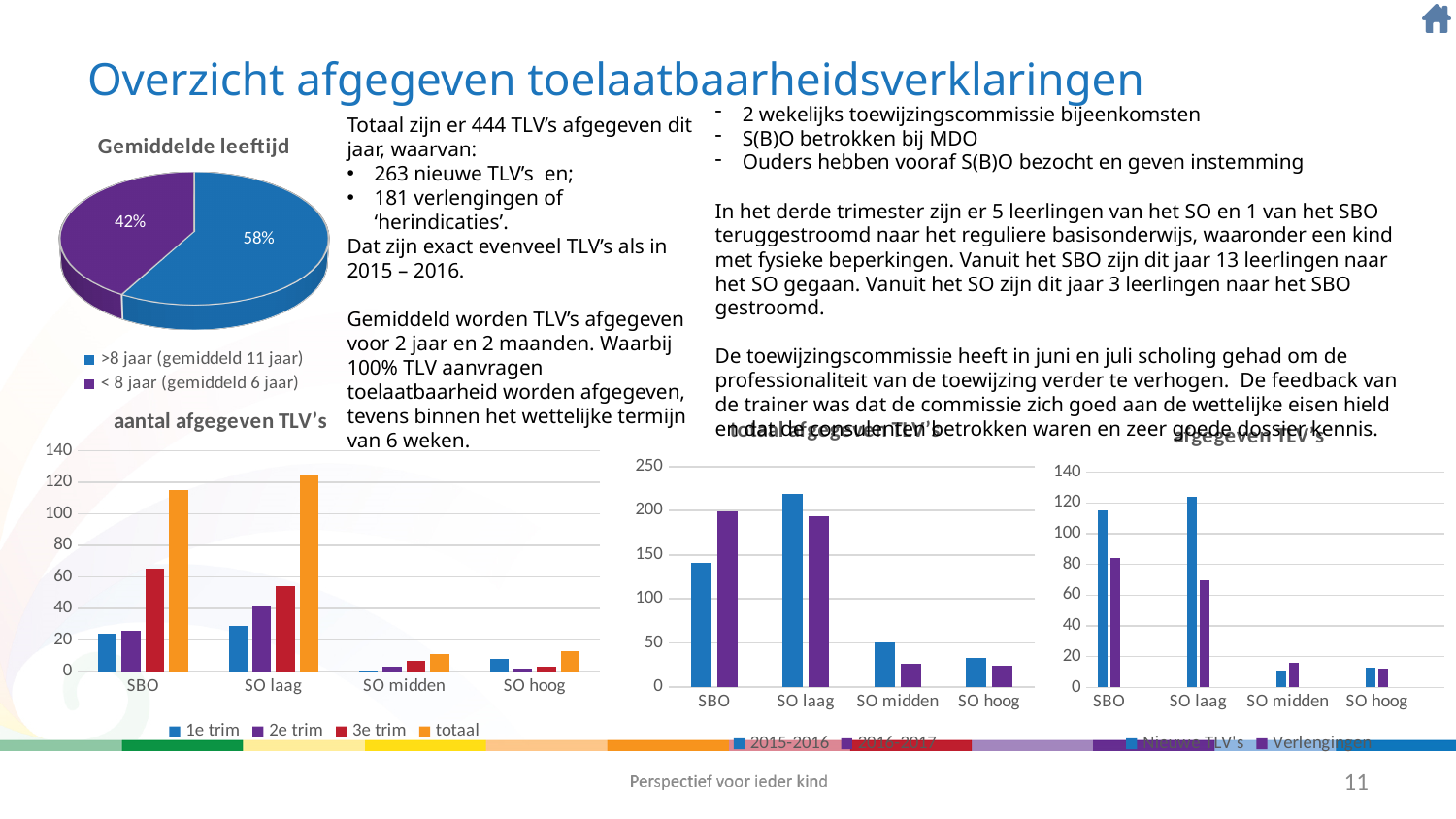
In the middle bar chart at the bottom of the slide, which series has the larger value for SBO: '2015-2016' or '2016-2017'? 2016-2017 In the bar chart 'afgegeven TLV's' at the bottom right, is the 'Nieuwe TLV's' value for SBO greater or less than 100? greater In the bar chart 'aantal afgegeven TLV's' at the bottom left, how many series does the legend list? 4 In the pie chart 'Gemiddelde leeftijd', what share is shown for '< 8 jaar (gemiddeld 6 jaar)'? 42% In the bar chart 'aantal afgegeven TLV's' at the bottom left, how many categories are shown on the x axis? 4 In the pie chart 'Gemiddelde leeftijd', what share is shown for '>8 jaar (gemiddeld 11 jaar)'? 58% In the bar chart 'aantal afgegeven TLV's' at the bottom left, is the '3e trim' value for SBO greater or less than 40? greater In the bar chart 'aantal afgegeven TLV's' at the bottom left, is the 'totaal' value for SBO greater or less than 100? greater In the pie chart 'Gemiddelde leeftijd', which slice is larger: '>8 jaar' or '< 8 jaar'? >8 jaar In the bar chart 'afgegeven TLV's' at the bottom right, which series has the larger value for SO laag: 'Nieuwe TLV's' or 'Verlengingen'? Nieuwe TLV's What kind of chart is the chart titled 'Gemiddelde leeftijd'? pie chart